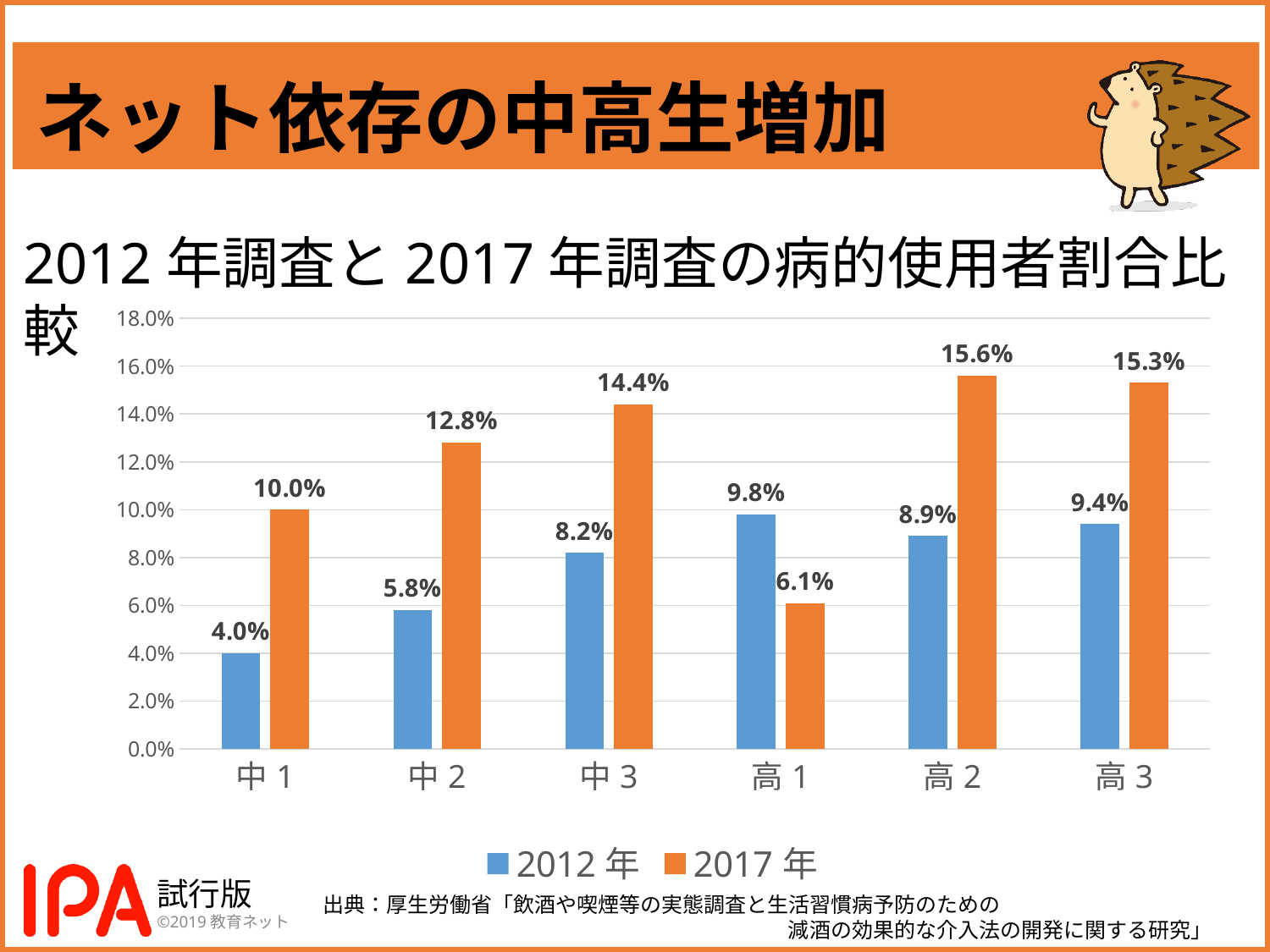
What is the 2012年 value for 高1? 9.8% For 高1, which is larger: the 2012年 value or the 2017年 value? 2012年 Is the 2017年 value for 高3 greater or less than 14.0%? greater What kind of chart is shown on the slide? bar chart What is the 2017年 value for 中3? 14.4% Which category has the lowest 2012年 value? 中1 What is the difference between the 2017年 and 2012年 values for 中2? 7.0% How many series does the legend list? 2 Which category has the lowest 2017年 value? 高1 Which category has the highest 2017年 value? 高2 How many categories are shown on the x axis? 6 What colour are the 2017年 bars? orange